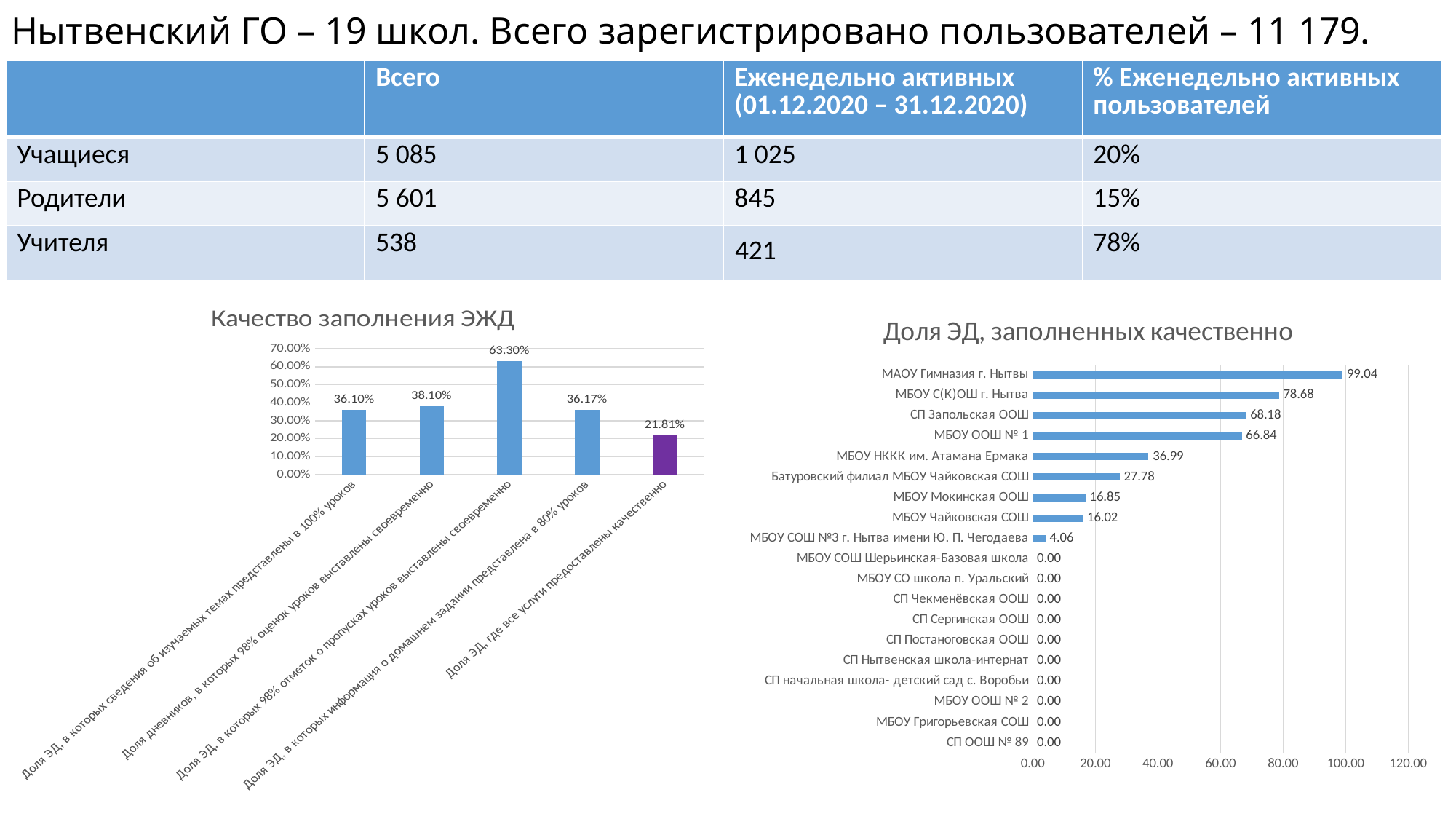
In the chart 'Качество заполнения ЭЖД', what is the difference between the value for 'Доля дневников, в которых 98% оценок уроков выставлены своевременно' and the value for 'Доля ЭД, в которых сведения об изучаемых темах представлены в 100% уроков'? 2.00% In the chart 'Доля ЭД, заполненных качественно', how many schools are listed? 19 In the chart 'Качество заполнения ЭЖД', what is the value for 'Доля ЭД, в которых 98% отметок о пропусках уроков выставлены своевременно'? 63.30% In the chart 'Качество заполнения ЭЖД', which category has the lowest value? Доля ЭД, где все услуги предоставлены качественно In the chart 'Доля ЭД, заполненных качественно', how many schools have a value of 0.00? 10 In the chart 'Качество заполнения ЭЖД', how many bars are plotted? 5 In the chart 'Доля ЭД, заполненных качественно', what is the value for 'МБОУ ООШ № 1'? 66.84 In the chart 'Доля ЭД, заполненных качественно', what is the difference between the values for 'МАОУ Гимназия г. Нытвы' and 'МБОУ С(К)ОШ г. Нытва'? 20.36 In the chart 'Доля ЭД, заполненных качественно', which school has the highest value? МАОУ Гимназия г. Нытвы In the chart 'Качество заполнения ЭЖД', what is the value for 'Доля ЭД, где все услуги предоставлены качественно'? 21.81% In the chart 'Доля ЭД, заполненных качественно', which is larger: the value for 'МБОУ Мокинская ООШ' or the value for 'Батуровский филиал МБОУ Чайковская СОШ'? Батуровский филиал МБОУ Чайковская СОШ In the chart 'Качество заполнения ЭЖД', what kind of chart is shown? Bar chart